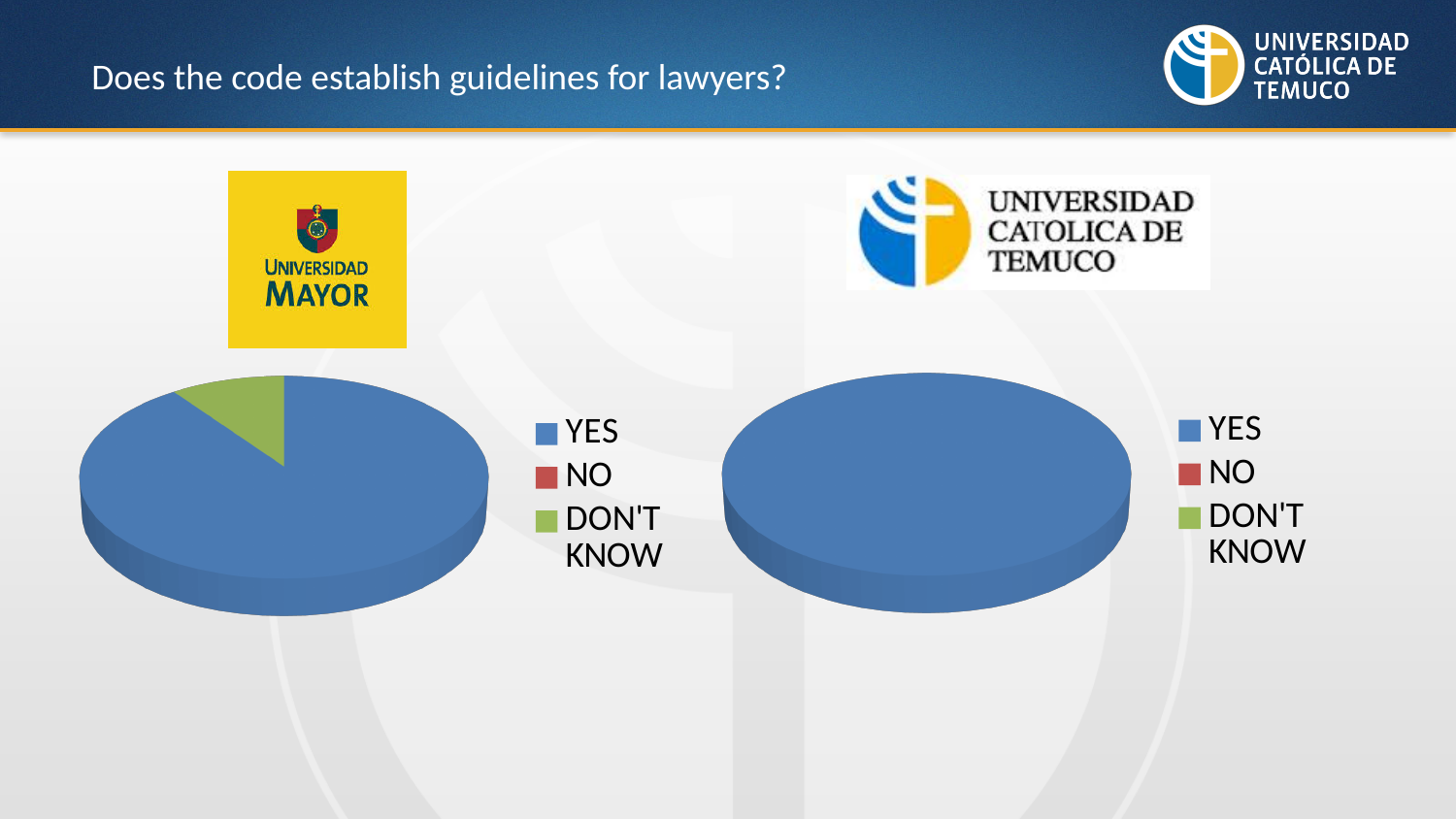
In the right chart (Universidad Católica de Temuco), which category has the largest slice? YES In the left chart (Universidad Mayor), which colour represents DON'T KNOW? Green How many entries does the legend of the right chart (Universidad Católica de Temuco) list? 3 How many pie charts are shown on the slide? 2 In the left chart (Universidad Mayor), which category has the largest slice? YES In the left chart (Universidad Mayor), which is larger, the YES slice or the DON'T KNOW slice? YES How many entries does the legend of the left chart (Universidad Mayor) list? 3 In the right chart (Universidad Católica de Temuco), which colour represents YES? Blue What kind of chart is the left chart (Universidad Mayor)? Pie chart What kind of chart is the right chart (Universidad Católica de Temuco)? Pie chart